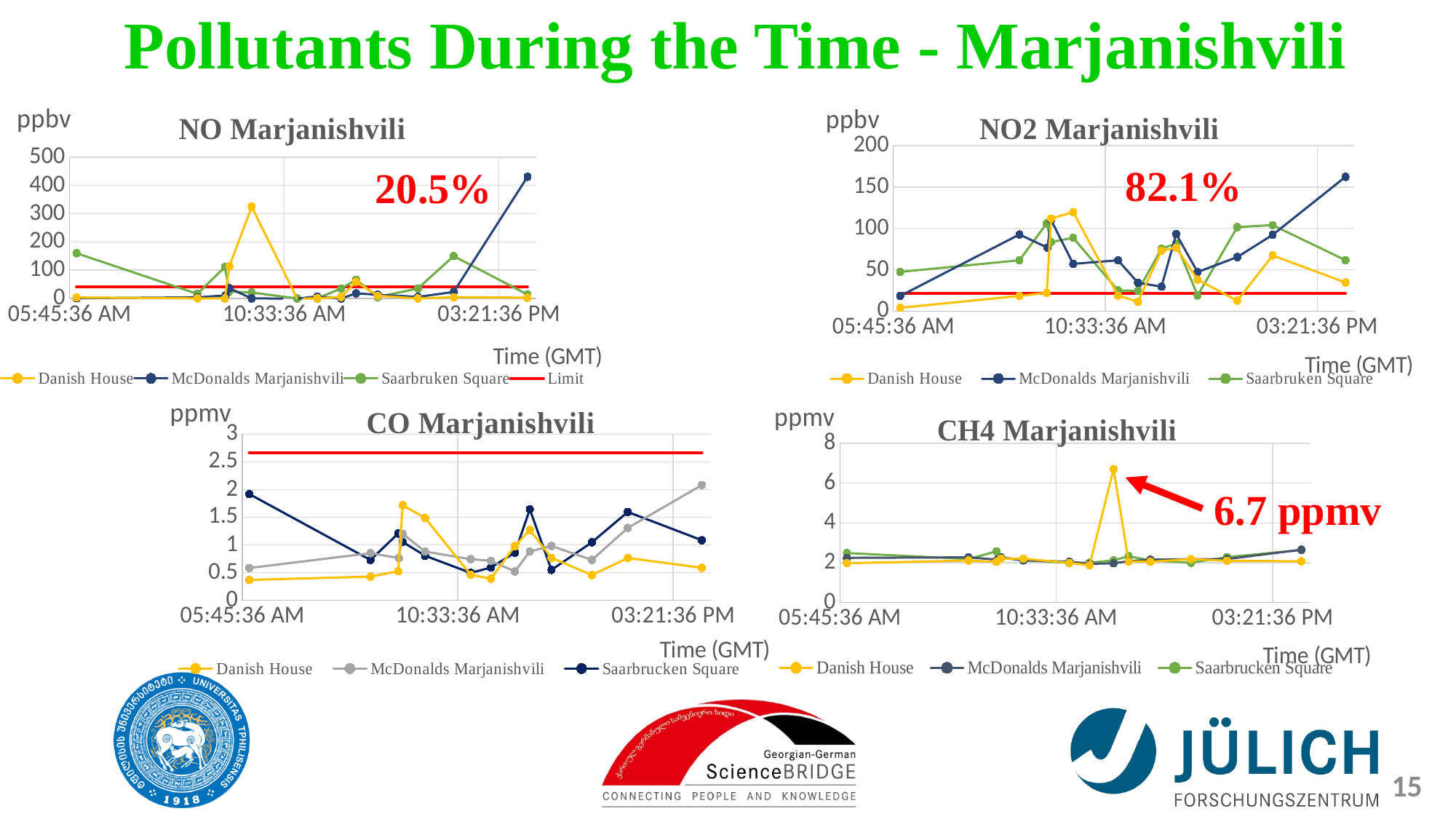
In the CH4 Marjanishvili chart, what is the peak value labelled for Danish House? 6.7 ppmv In the NO Marjanishvili chart, which series reaches the highest value? McDonalds Marjanishvili In the CH4 Marjanishvili chart, which series reaches the highest value? Danish House What unit is shown on the y axis of the CO Marjanishvili chart? ppmv What percentage is annotated in red on the NO2 Marjanishvili chart? 82.1% How many series does the legend of the NO2 Marjanishvili chart list? 3 In the CO Marjanishvili chart, is the highest value for McDonalds Marjanishvili greater or less than 2.5? less In the CO Marjanishvili chart, at the last time point, which is larger: McDonalds Marjanishvili or Saarbrucken Square? McDonalds Marjanishvili In the NO2 Marjanishvili chart, is the final value for McDonalds Marjanishvili greater or less than 150? greater How many series does the legend of the NO Marjanishvili chart list? 4 What kind of chart is the NO Marjanishvili chart? line chart In the NO Marjanishvili chart, is the final value for McDonalds Marjanishvili greater or less than 400? greater